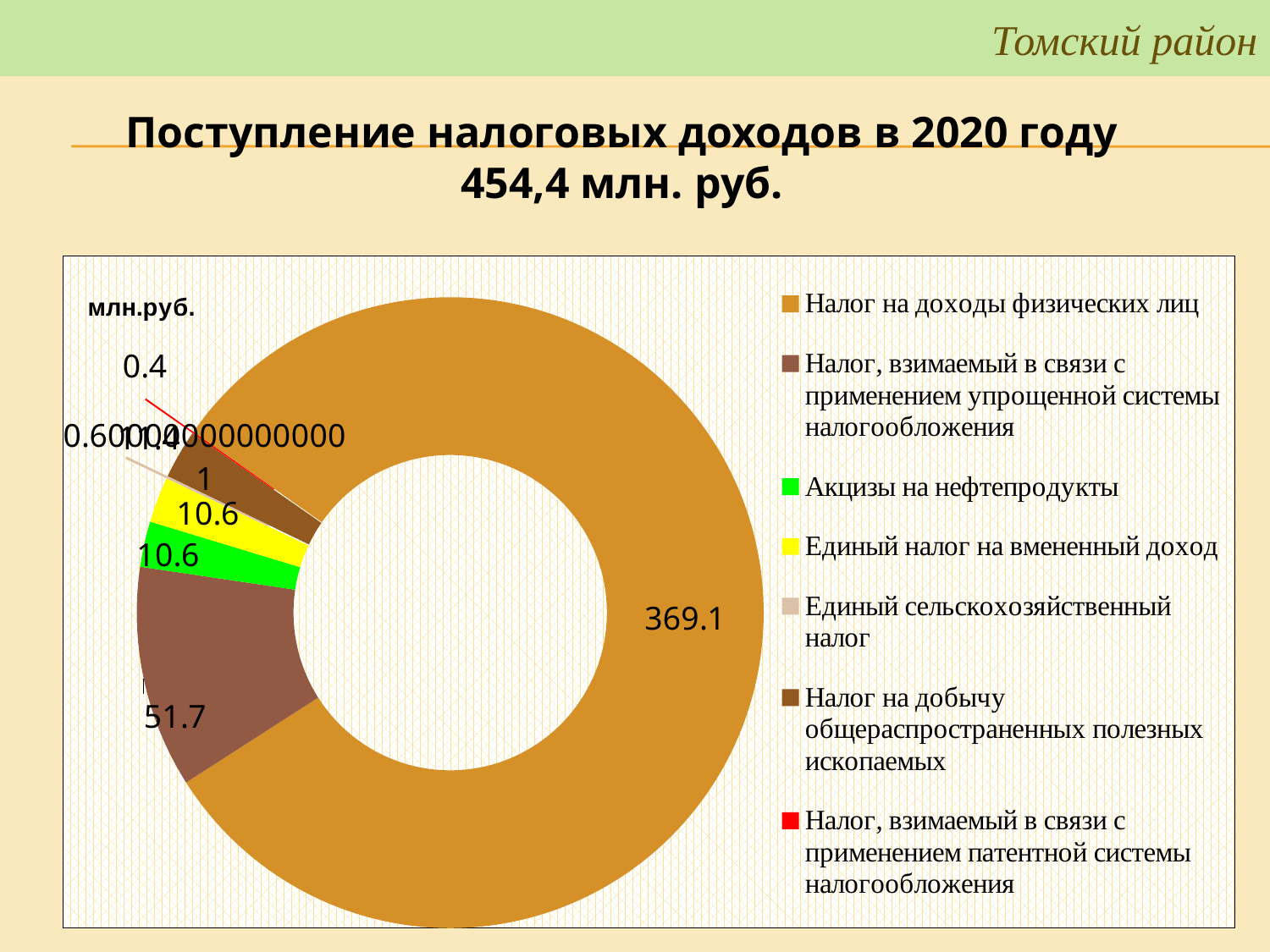
What is the difference between "Налог, взимаемый в связи с применением упрощенной системы налогообложения" (51.7) and "Акцизы на нефтепродукты" (10.6)? 41.1 What total amount of tax revenue for 2020 is stated in the slide title? 454,4 млн. руб. What is the value for "Единый налог на вмененный доход"? 10.6 Which category has the largest value in the chart? Налог на доходы физических лиц What is the value for "Налог, взимаемый в связи с применением упрощенной системы налогообложения"? 51.7 What is the value for "Акцизы на нефтепродукты"? 10.6 What is the value for "Налог на доходы физических лиц"? 369.1 What is the value for "Налог, взимаемый в связи с применением патентной системы налогообложения"? 0.4 How many categories does the legend of the chart list? 7 What is the difference between "Налог на доходы физических лиц" (369.1) and "Налог, взимаемый в связи с применением упрощенной системы налогообложения" (51.7)? 317.4 Which is larger: "Налог на доходы физических лиц" or "Налог, взимаемый в связи с применением упрощенной системы налогообложения"? Налог на доходы физических лиц What kind of chart is shown on the slide? doughnut (pie) chart